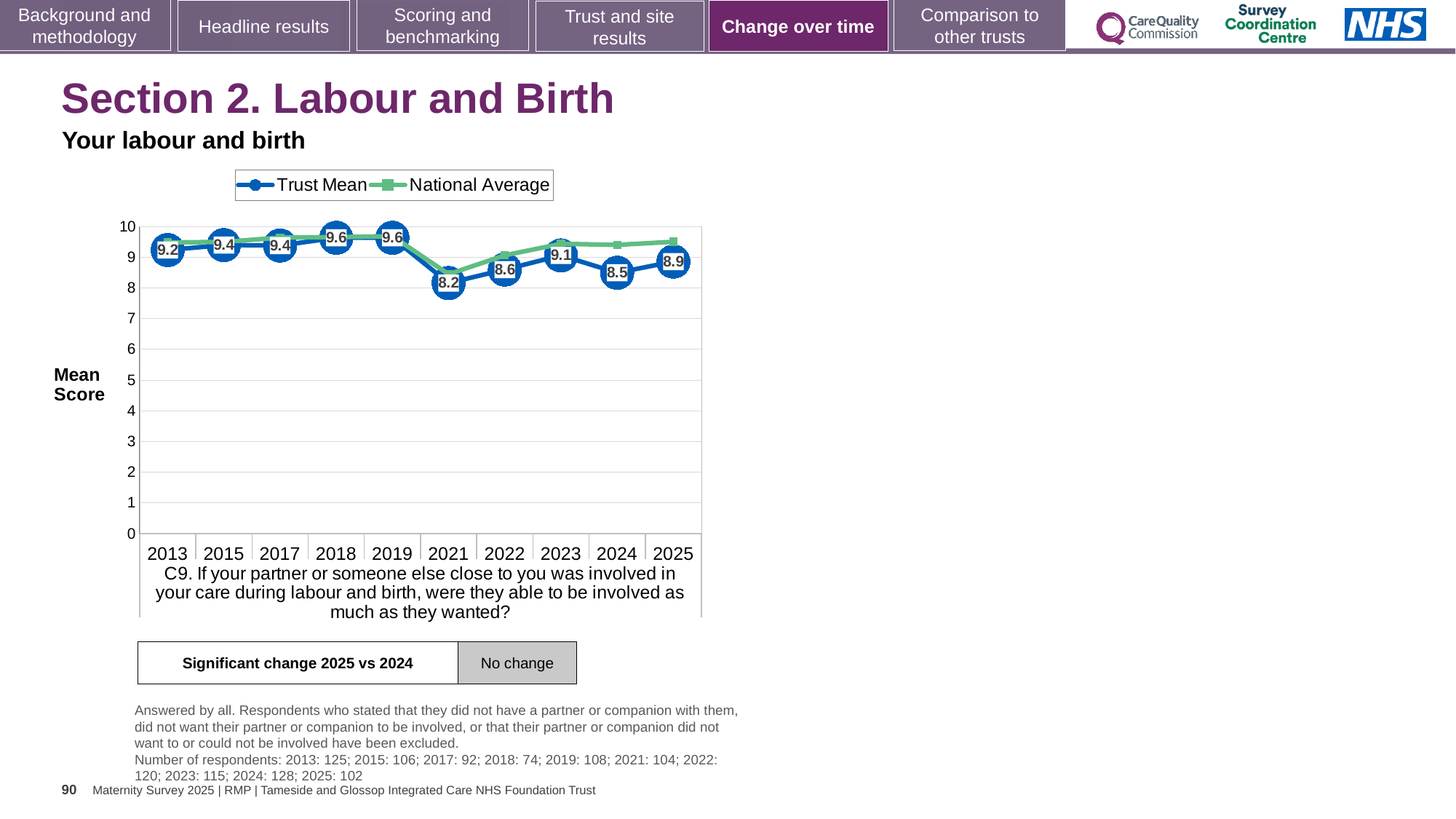
Is the National Average for 2025 greater or less than 9? greater How many series does the legend list? 2 What is the Trust Mean score for 2025? 8.9 Does the Trust Mean rise or fall from 2024 to 2025? rise In which year is the Trust Mean lowest? 2021 What is the difference between the Trust Mean in 2019 and in 2021? 1.4 Which is larger, the Trust Mean in 2023 or in 2024? 2023 What is the label of the y axis? Mean Score What is the Trust Mean score for 2013? 9.2 How many years are shown on the x axis? 10 What is the Trust Mean score for 2021? 8.2 What kind of chart is shown? line chart